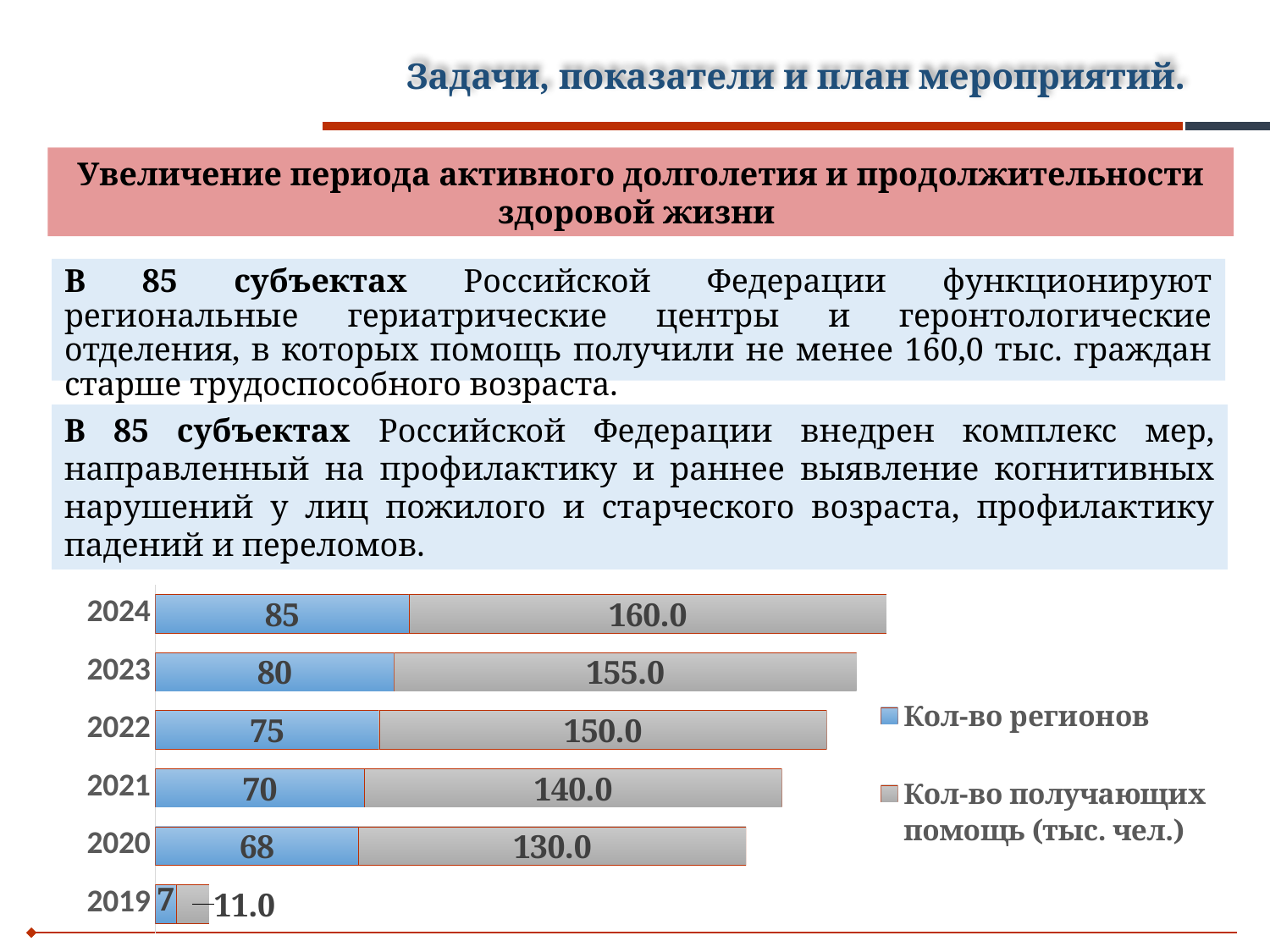
Which is larger: the "Кол-во получающих помощь (тыс. чел.)" value for 2022 or for 2020? 2022 What is the value of "Кол-во получающих помощь (тыс. чел.)" for 2021? 140.0 What is the total of the stacked bar for 2023? 235.0 Which year has the highest value for "Кол-во получающих помощь (тыс. чел.)"? 2024 What kind of chart is shown on the slide? Stacked bar chart Which colour represents "Кол-во регионов" in the chart? Blue How many years are shown on the chart? 6 Which year has the lowest value for "Кол-во регионов"? 2019 What is the value of "Кол-во регионов" for 2019? 7 What is the difference between the "Кол-во регионов" values for 2024 and 2020? 17 How many series does the legend list? 2 What is the value of "Кол-во регионов" for 2024? 85